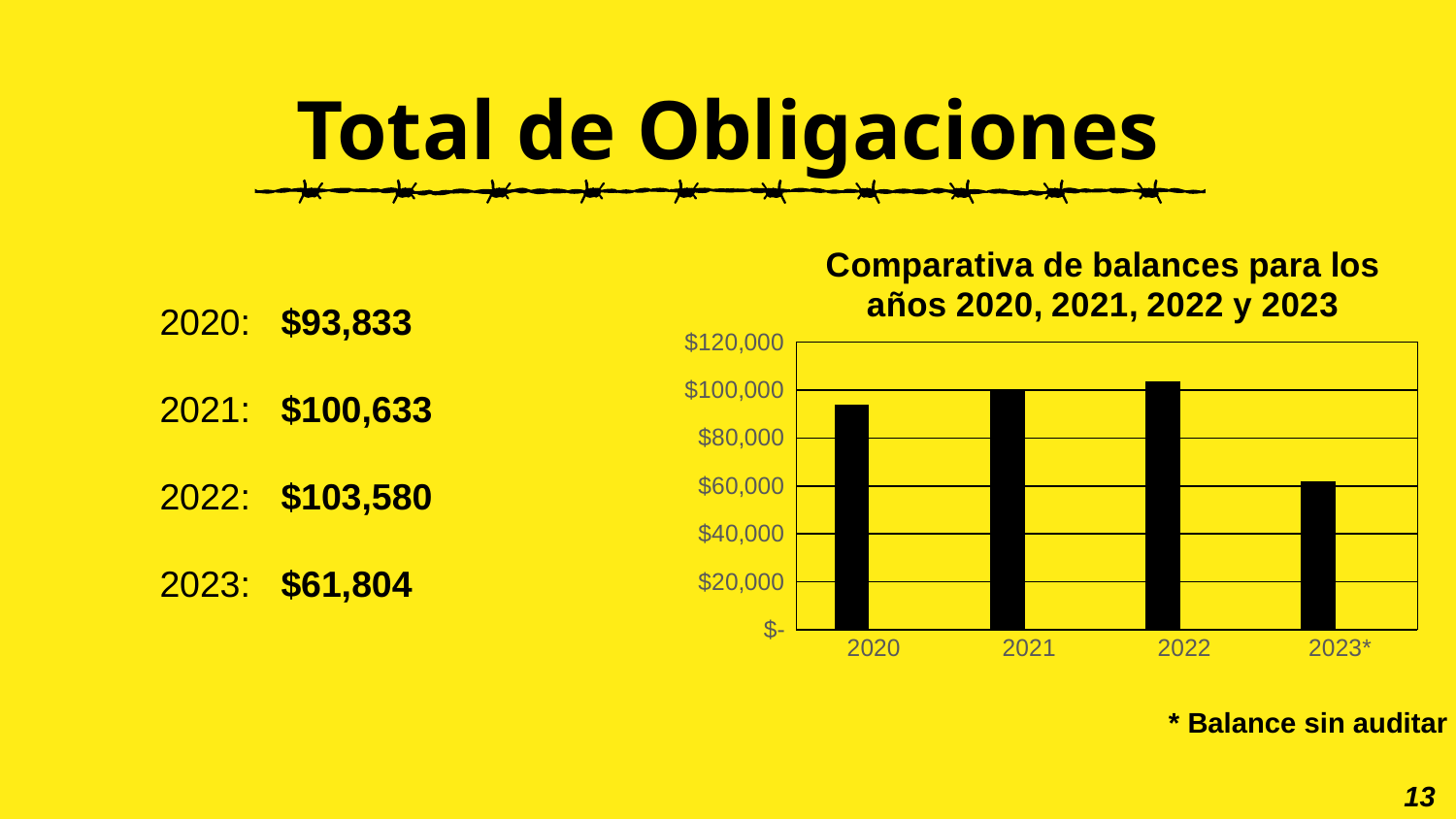
What is the value for 2022? $103,580 Is the value for 2020 greater or less than $100,000? less What is the difference between the values for 2022 and 2023? $41,776 What is the value for 2023? $61,804 How many bars (years) are plotted in the chart? 4 Which year has the lowest value? 2023 What is the value for 2020? $93,833 What type of chart is shown on the slide? bar chart What is the value for 2021? $100,633 What is the title of the chart? Comparativa de balances para los años 2020, 2021, 2022 y 2023 Which year has the highest value? 2022 Which is larger, the value for 2020 or the value for 2021? 2021